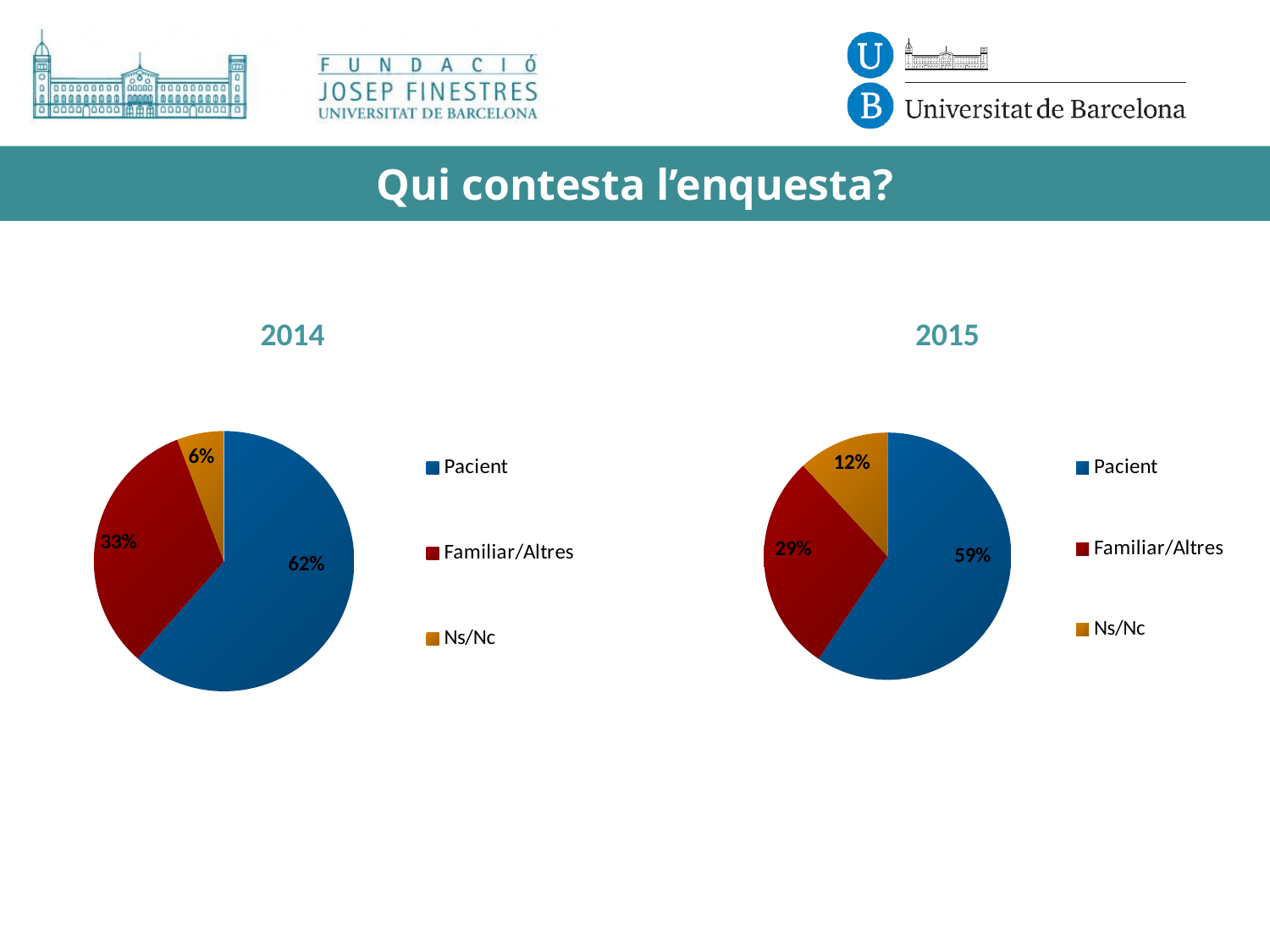
What is the difference between the Pacient share in 2014 and in 2015? 3 percentage points In the 2014 pie chart, which category has the smallest share? Ns/Nc In the 2015 pie chart, what percentage is shown for Ns/Nc? 12% Is the Ns/Nc share larger in the 2014 chart or the 2015 chart? 2015 How many categories does the 2014 pie chart show? 3 Which colour represents Familiar/Altres in the 2014 pie chart? Red What type of chart is used for the 2015 data? Pie chart In the 2014 pie chart, what percentage is shown for Ns/Nc? 6% In the 2014 pie chart, what share of respondents were Pacient? 62% In the 2015 pie chart, what share of respondents were Familiar/Altres? 29% In the 2015 pie chart, which category has the largest share? Pacient In the 2015 pie chart, what is the difference between the Familiar/Altres share and the Ns/Nc share? 17 percentage points